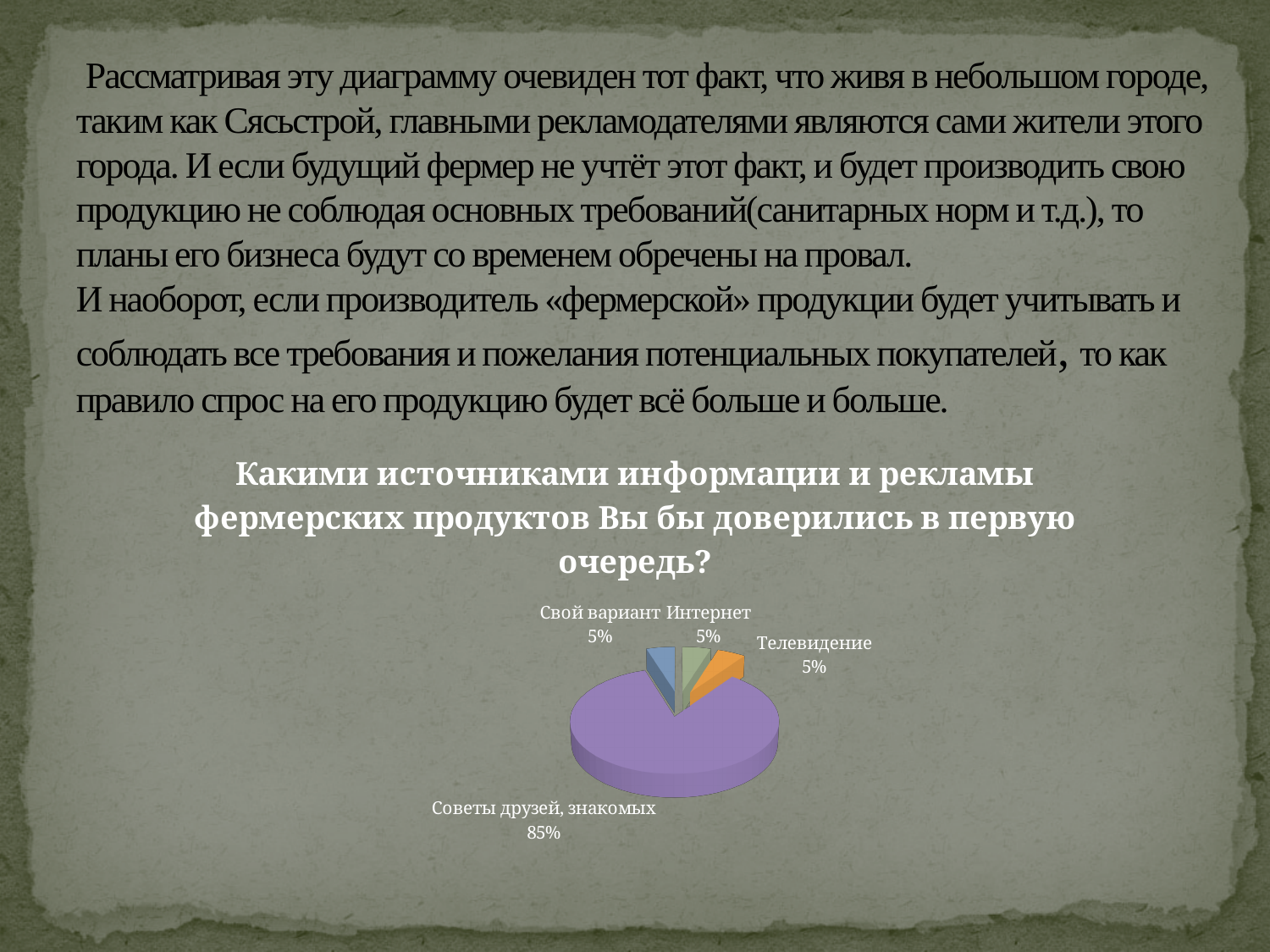
Which category has the largest slice of the pie? Советы друзей, знакомых What kind of chart is shown on the slide? Pie chart What is the difference between the share for "Советы друзей, знакомых" and the share for "Телевидение"? 80% What is the value shown for "Интернет"? 5% Which is larger: the share for "Советы друзей, знакомых" or the share for "Интернет"? Советы друзей, знакомых What is the title of the pie chart? Какими источниками информации и рекламы фермерских продуктов Вы бы доверились в первую очередь? What colour is the slice for "Советы друзей, знакомых"? Purple What is the value shown for "Свой вариант"? 5% What share of the pie does "Советы друзей, знакомых" have? 85% What is the value shown for "Телевидение"? 5% How many slices does the pie chart have? 4